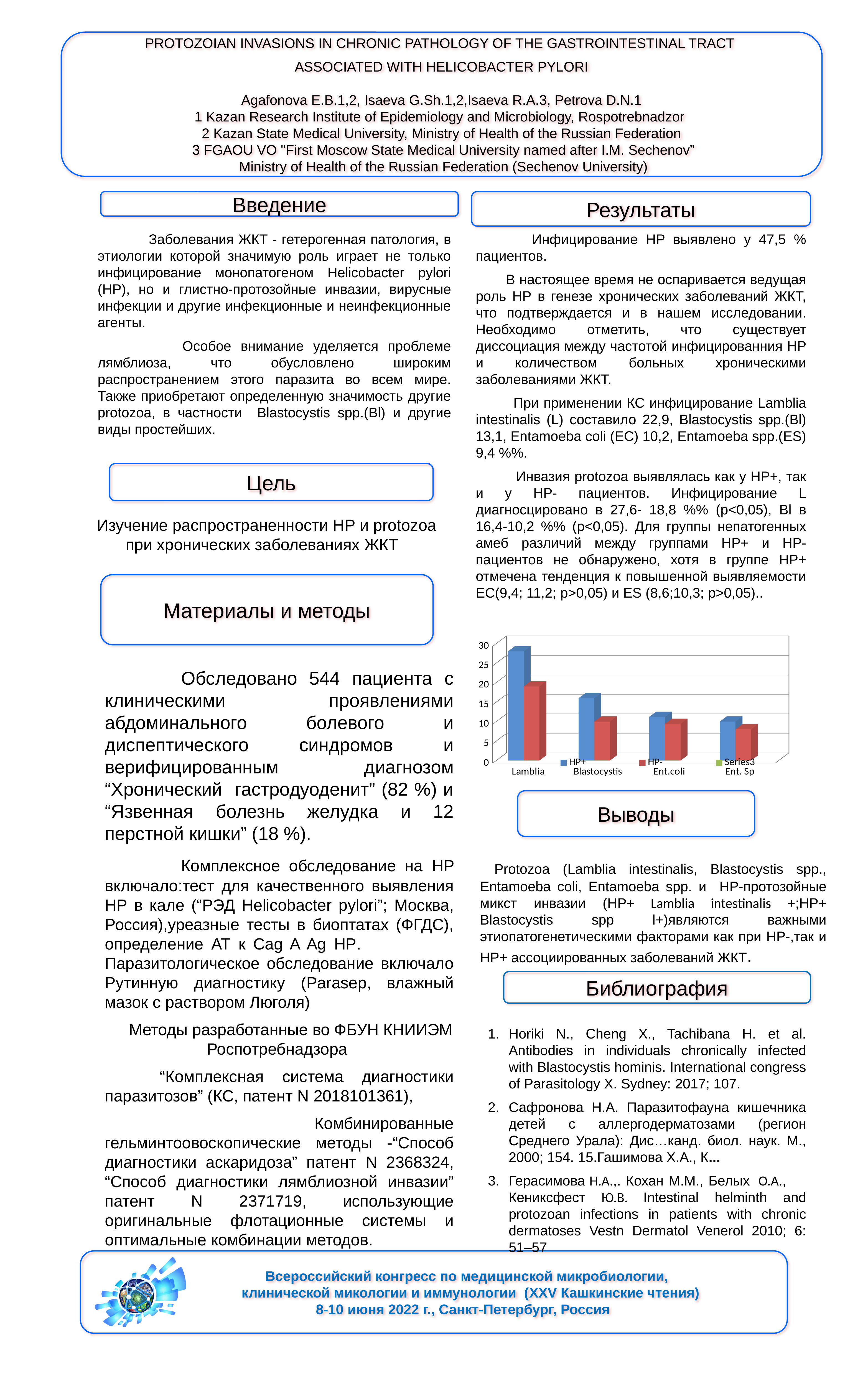
Is the HP- value for Lamblia greater or less than 15? greater How many series does the chart legend list? 3 For Blastocystis, which is larger: the HP+ value or the HP- value? HP+ For Lamblia, which is larger: the HP+ value or the HP- value? HP+ Is the HP+ value for Lamblia greater or less than 25? greater Which category has the highest HP+ value in the chart? Lamblia How many categories are shown on the x axis of the chart? 4 Is the HP- value for Blastocystis greater or less than 15? less What kind of chart is shown on the slide? bar chart Which category has the highest HP- value in the chart? Lamblia Do the HP+ values rise or fall moving from Lamblia to Ent. Sp along the x axis? fall What are the entries listed in the chart legend? HP+, HP-, Series3